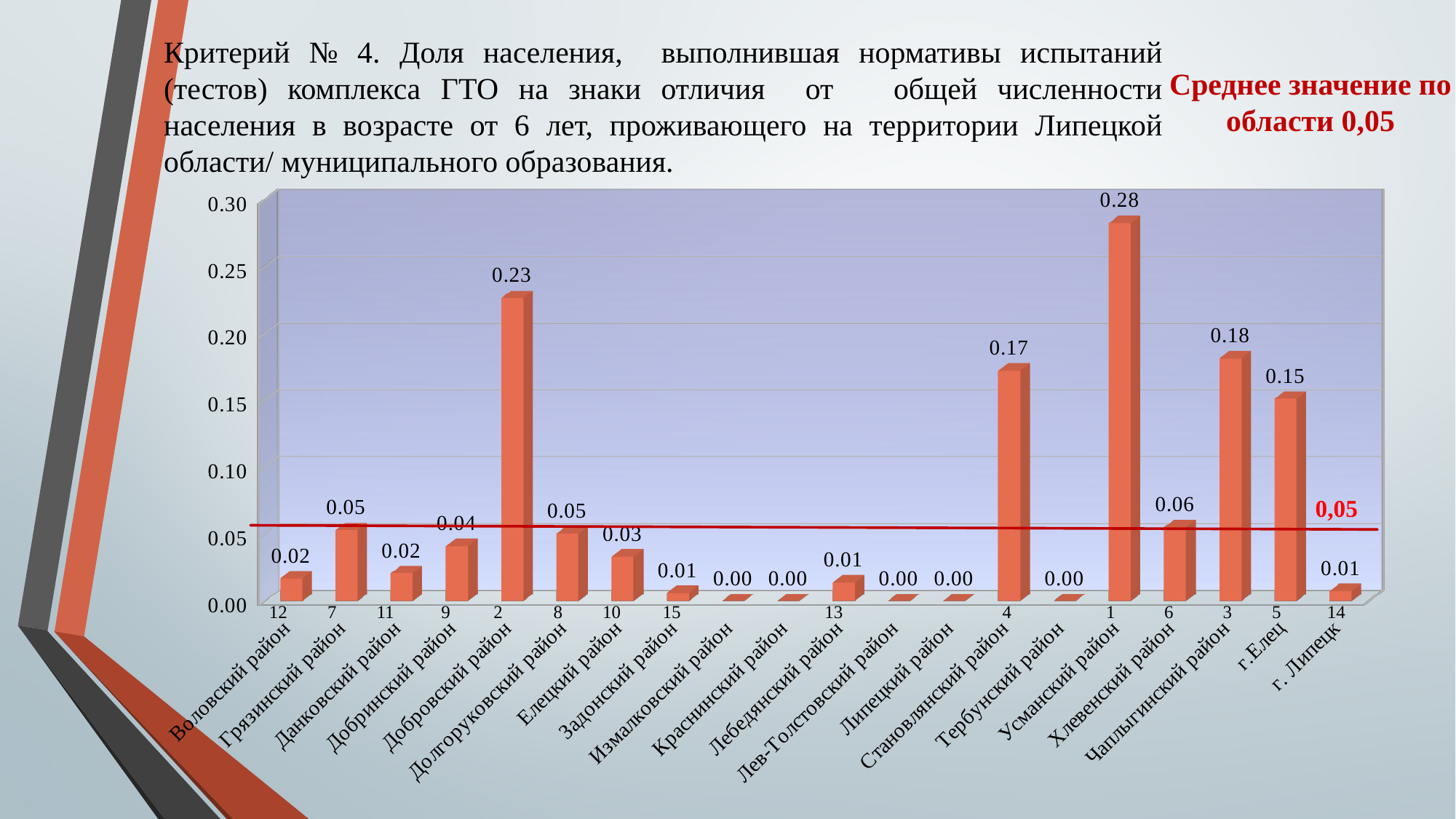
What value does the red horizontal line on the chart mark? 0,05 Which category has the highest value? Усманский район What is the value for Усманский район? 0.28 What is the difference between the values for Чаплыгинский район and Становлянский район? 0.01 Is the value for Добровский район greater or less than 0.20? greater How many categories are shown on the x axis? 20 Which is larger, the value for Становлянский район or the value for г.Елец? Становлянский район What is the value for Добровский район? 0.23 What is the value for г.Елец? 0.15 What is the difference between the values for Усманский район and Добровский район? 0.05 What is the value for Хлевенский район? 0.06 What kind of chart is shown on the slide? bar chart